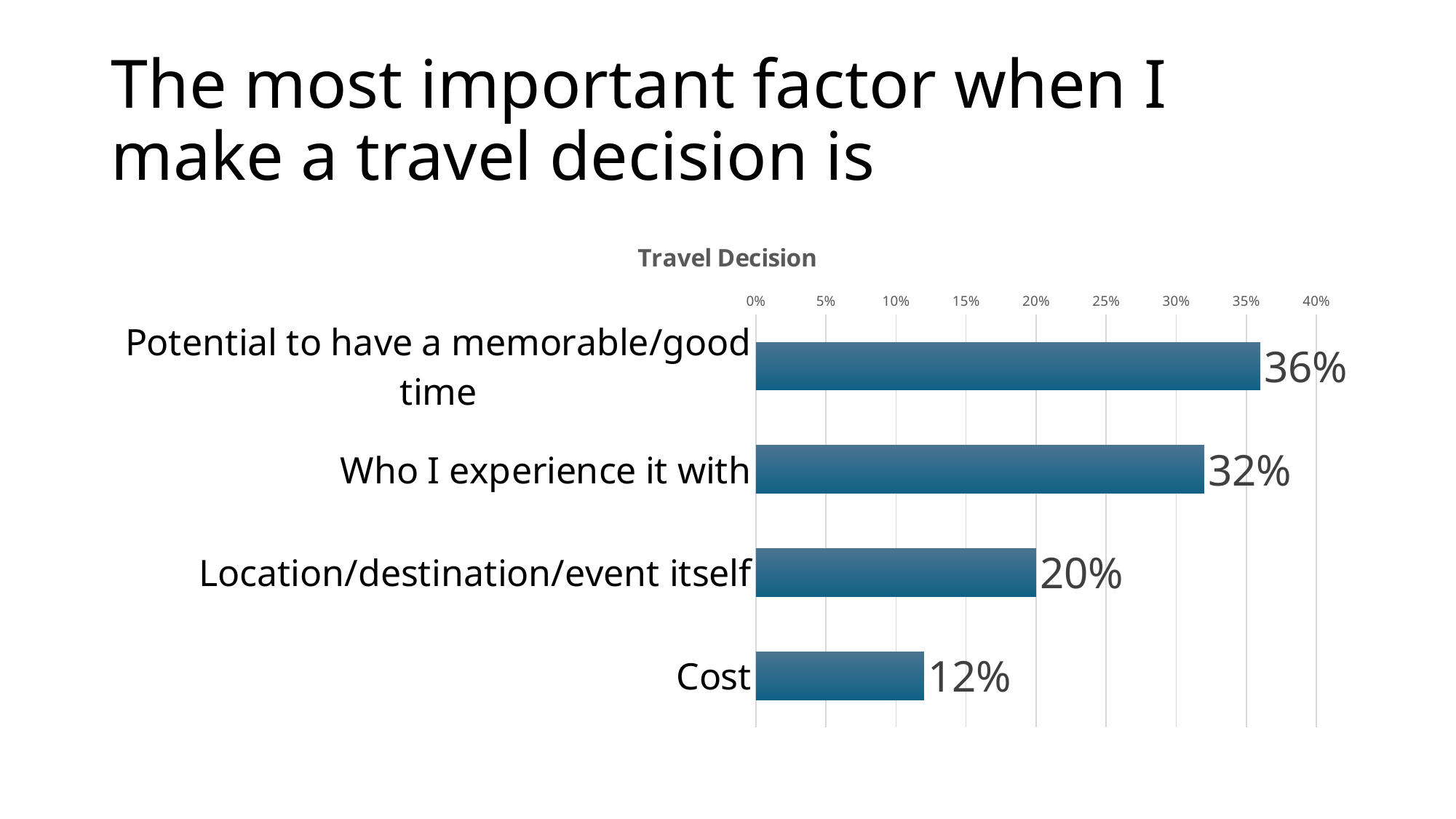
Which category has the highest value? Potential to have a memorable/good time Which is larger, the value for "Location/destination/event itself" or the value for "Cost"? Location/destination/event itself What is the title of the chart? Travel Decision What kind of chart is shown on the slide? Bar chart What is the difference between the values for "Potential to have a memorable/good time" and "Cost"? 24% What is the difference between the values for "Who I experience it with" and "Location/destination/event itself"? 12% What is the value for "Cost"? 12% What is the value for "Potential to have a memorable/good time"? 36% What is the value for "Location/destination/event itself"? 20% How many categories are shown in the chart? 4 Which category has the lowest value? Cost What is the value for "Who I experience it with"? 32%